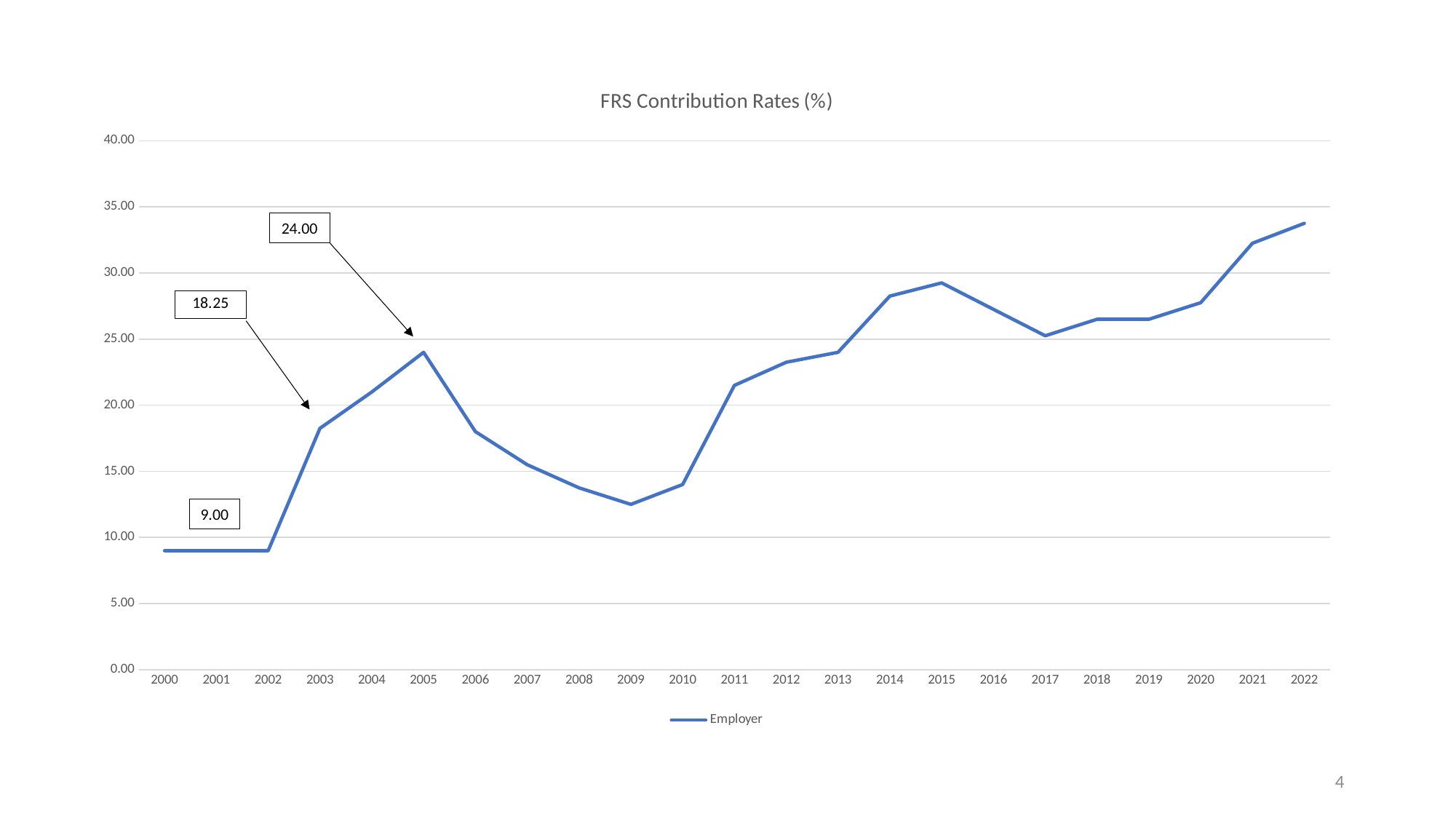
Do the values rise or fall from 2005 to 2009? fall Which year has the highest Employer contribution rate? 2022 Which year has the larger value, 2015 or 2017? 2015 What kind of chart is shown on the slide? line chart Is the value for 2011 greater or less than 20.00? greater What is the Employer contribution rate for 2003? 18.25 What is the difference between the 2005 value (24.00) and the 2003 value (18.25)? 5.75 Is the value for 2022 greater or less than 30.00? greater Is the value for 2009 greater or less than 15.00? less What is the Employer contribution rate for 2000? 9.00 What is the Employer contribution rate for 2005? 24.00 How many years are plotted on the x axis? 23